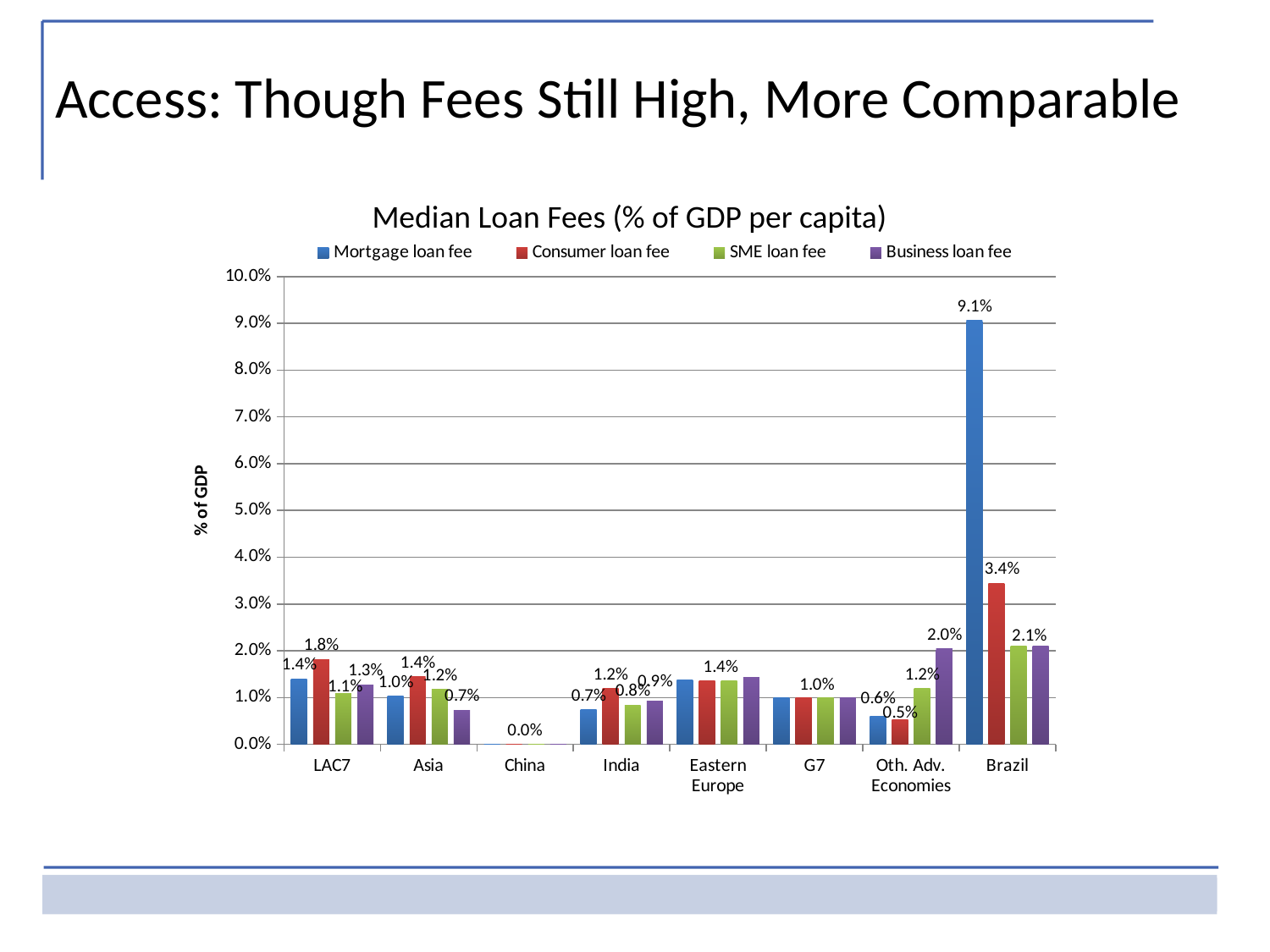
What is the Business loan fee for Oth. Adv. Economies? 2.0% What is the difference between the Mortgage loan fee and the Consumer loan fee for Brazil? 5.7% What is the Consumer loan fee for Oth. Adv. Economies? 0.5% What is the Consumer loan fee for LAC7? 1.8% What is the Mortgage loan fee for Brazil? 9.1% What kind of chart is shown on the slide? bar chart How many categories are shown on the x axis? 8 What is the Consumer loan fee for Brazil? 3.4% Which category has the highest Mortgage loan fee? Brazil How many series does the legend list? 4 Which is larger, the Consumer loan fee for LAC7 or the Consumer loan fee for Asia? LAC7 Is the Mortgage loan fee for Brazil greater or less than 5.0%? greater